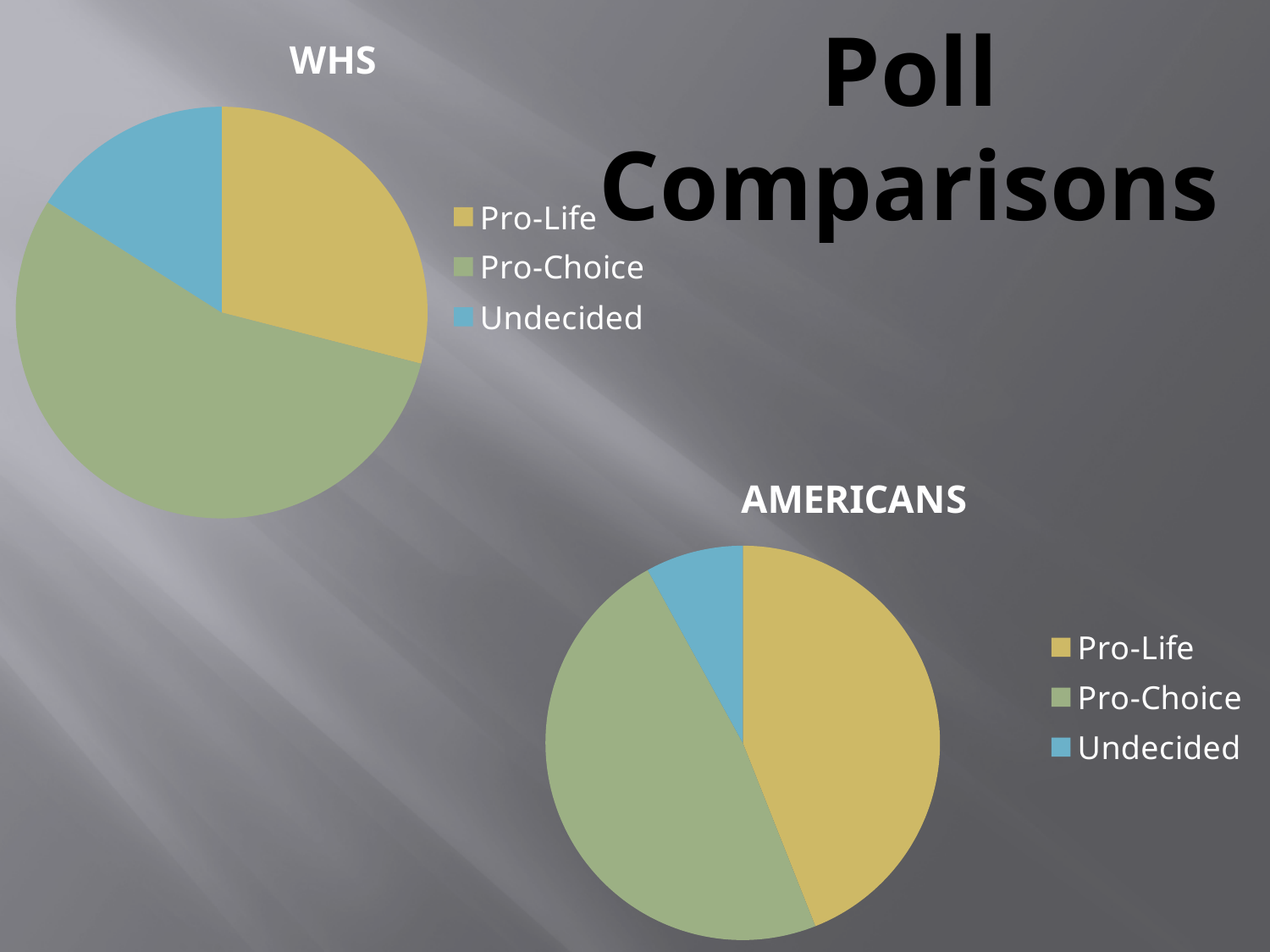
In the AMERICANS chart, how many categories does the legend list? 3 In the WHS chart, which category has the smallest slice? Undecided In the WHS chart, how many slices does the pie have? 3 In the WHS chart, which is larger, the Pro-Life slice or the Undecided slice? Pro-Life In the AMERICANS chart, what colour represents the Undecided category? Blue What is the title of the slide containing the two pie charts? Poll Comparisons What kind of chart is the AMERICANS chart? Pie chart What kind of chart is the WHS chart? Pie chart In the AMERICANS chart, which is larger, the Pro-Life slice or the Undecided slice? Pro-Life In the AMERICANS chart, which category has the smallest slice? Undecided In the WHS chart, which is larger, the Pro-Choice slice or the Pro-Life slice? Pro-Choice In the WHS chart, which category has the largest slice? Pro-Choice